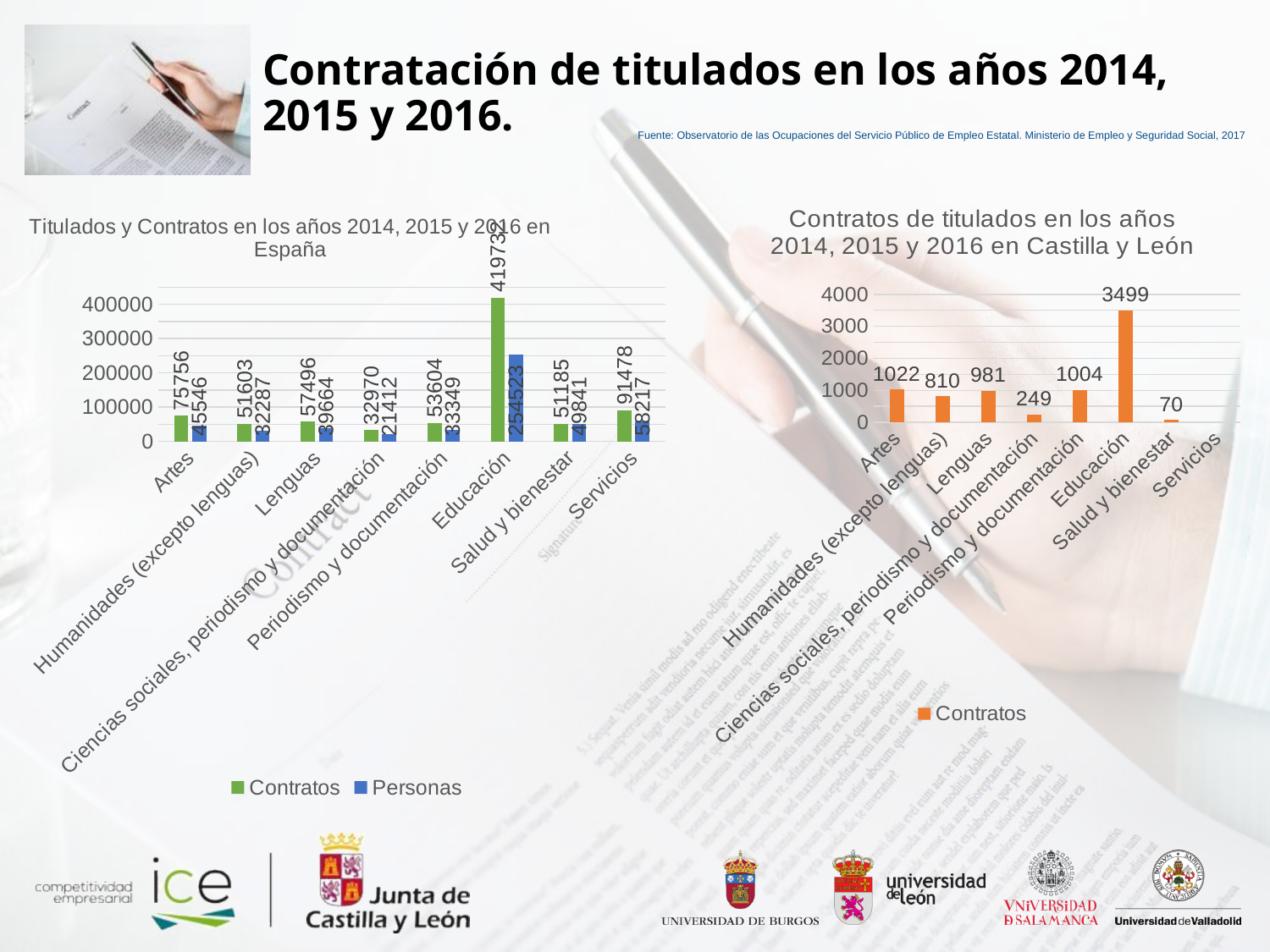
In the left chart (España), what is the Contratos value for Educación? 419732 In the left chart (España), which has more Contratos, Artes or Servicios? Servicios In the left chart (España), how many series does the legend list? 2 In the left chart (España), what is the Personas value for Servicios? 58217 In the right chart (Castilla y León), what is the Contratos value for Artes? 1022 In the left chart (España), which category has the highest Contratos value? Educación In the right chart (Castilla y León), which category has the highest value? Educación In the right chart (Castilla y León), what is the Contratos value for Educación? 3499 What kind of chart is the left chart titled 'Titulados y Contratos en los años 2014, 2015 y 2016 en España'? Bar chart In the right chart (Castilla y León), what is the difference between the values for Artes and Lenguas? 41 In the left chart (España), what is the difference between Contratos and Personas for Artes? 30210 In the left chart (España), what is the Personas value for Salud y bienestar? 49841